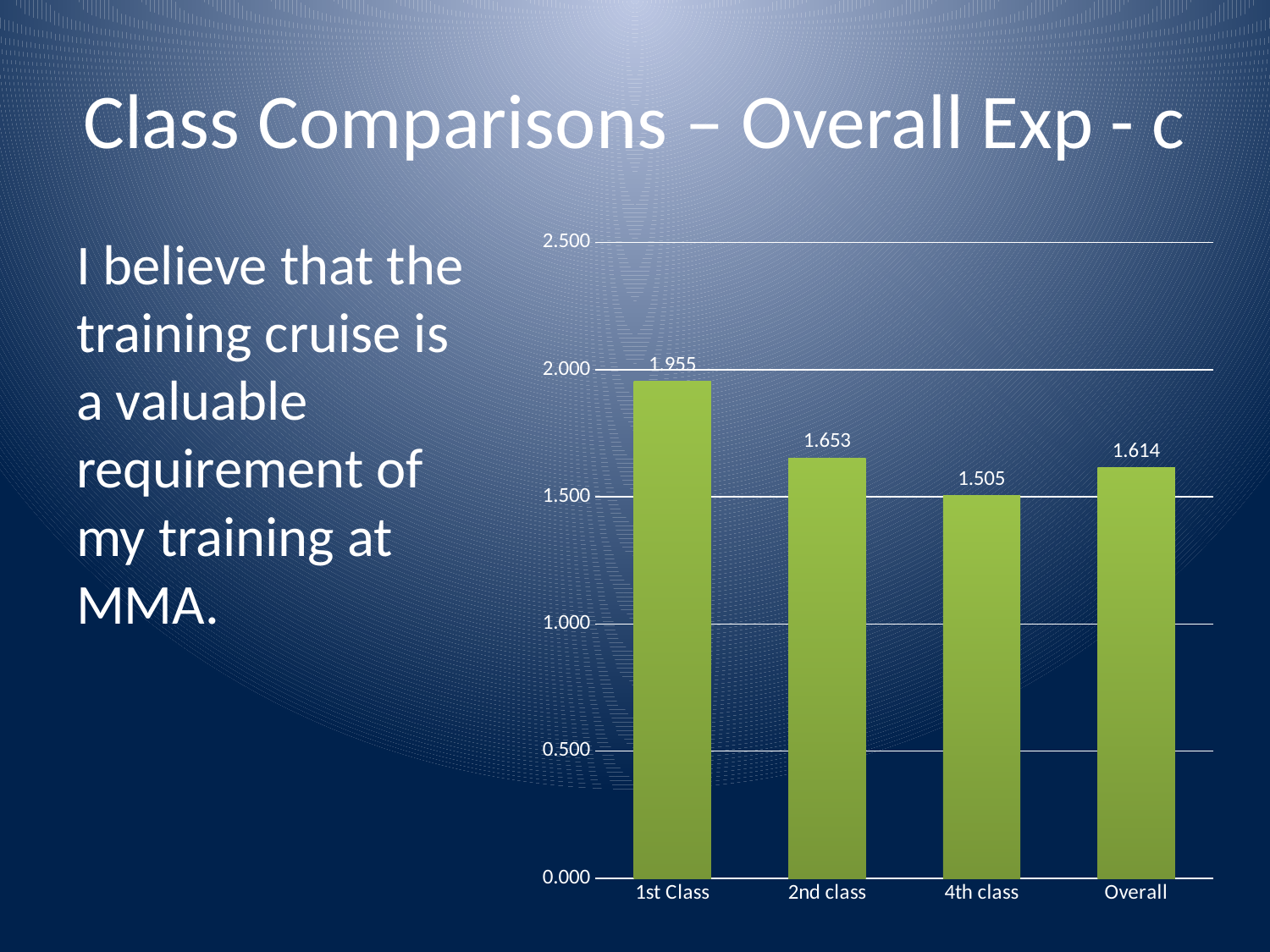
What is the difference between the values for 2nd class and Overall? 0.039 What is the value for 4th class? 1.505 Which is larger, the value for 2nd class or the value for Overall? 2nd class What is the difference between the values for 1st Class and 4th class? 0.450 What is the value for 2nd class? 1.653 Which category has the lowest value? 4th class What kind of chart is shown on the slide? bar chart Which category has the highest value? 1st Class Is the value for 1st Class greater or less than 2.000? less What is the value for 1st Class? 1.955 How many categories are shown on the x axis? 4 What is the value for Overall? 1.614